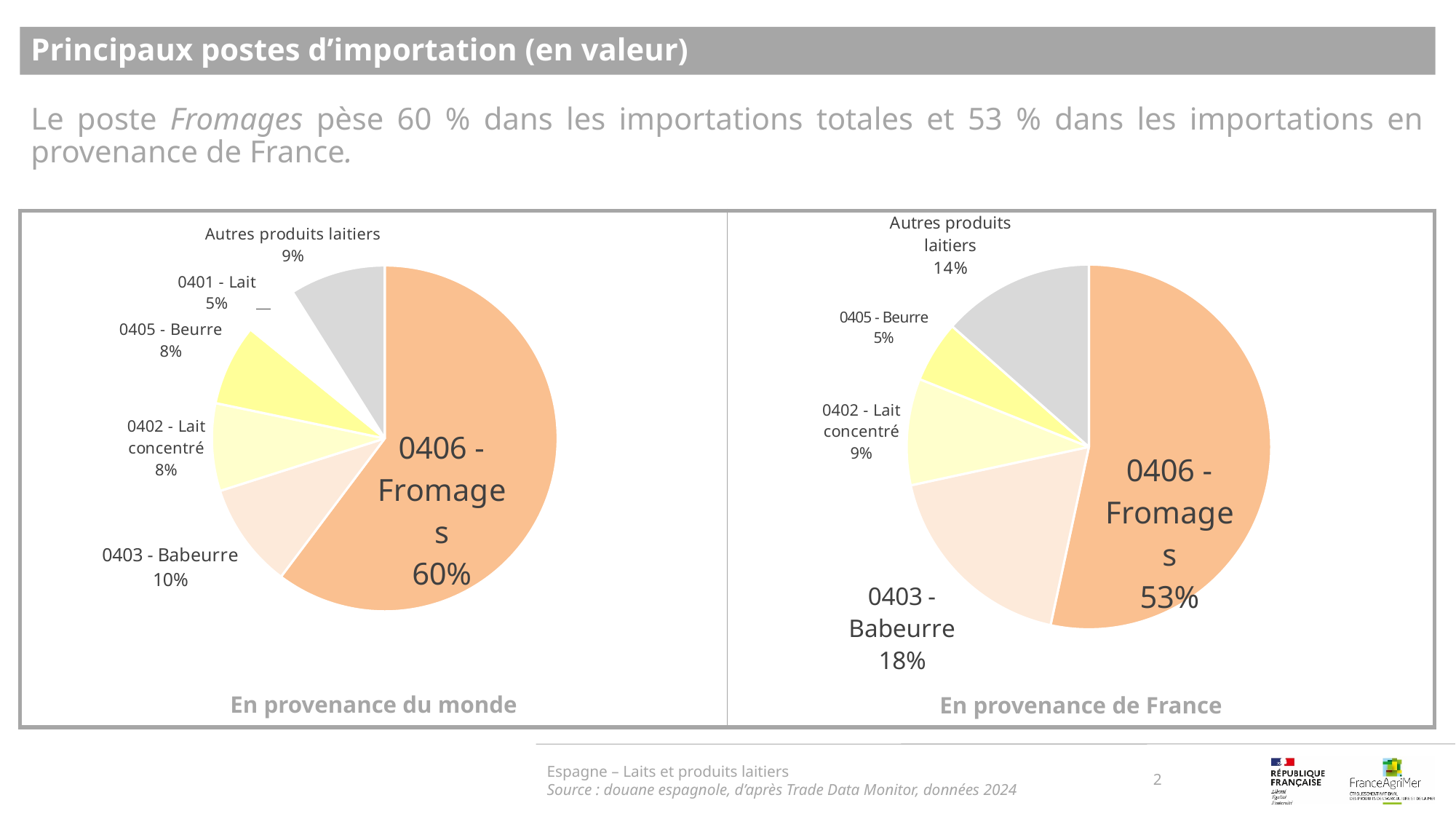
In the 'En provenance de France' chart, what is the difference between 0403 - Babeurre and 0402 - Lait concentré? 9 percentage points In the 'En provenance de France' chart, which category has the largest share? 0406 - Fromages In the 'En provenance de France' chart, which category has the smallest share? 0405 - Beurre In the 'En provenance du monde' chart, which category has the smallest share? 0401 - Lait What type of chart is used in the 'En provenance de France' panel? Pie chart In the 'En provenance de France' chart, what share does 0403 - Babeurre have? 18% In the 'En provenance du monde' chart, which is larger: 0403 - Babeurre or Autres produits laitiers? 0403 - Babeurre In the 'En provenance du monde' chart, what is the value for 0401 - Lait? 5% In the 'En provenance de France' chart, what is the value for Autres produits laitiers? 14% How many slices does the 'En provenance du monde' pie chart have? 6 What is the difference between the share of 0406 - Fromages in the 'En provenance du monde' chart and in the 'En provenance de France' chart? 7 percentage points In the 'En provenance du monde' chart, what share does 0406 - Fromages have? 60%